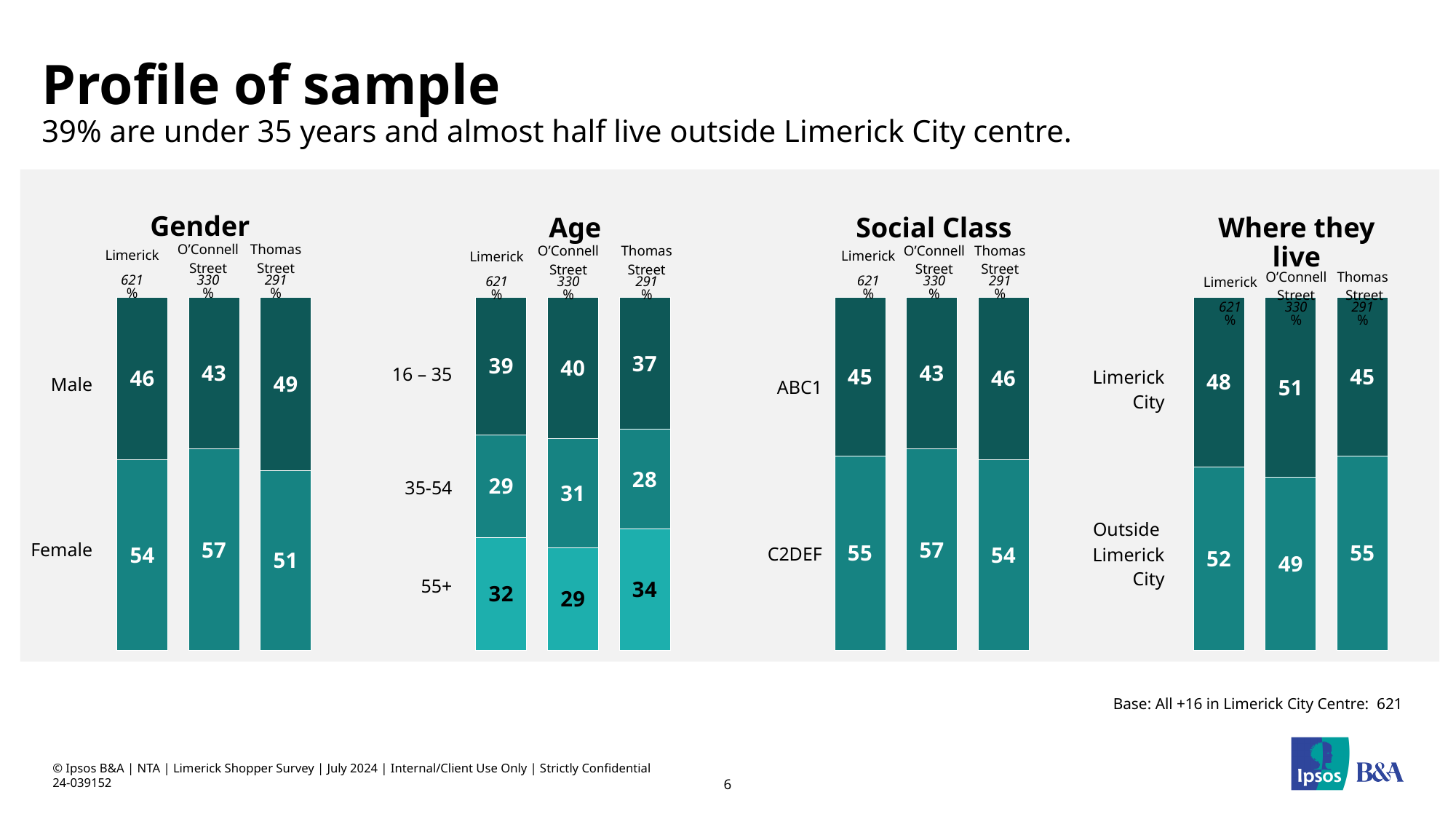
In the Gender chart, what percentage of the Limerick sample is Female? 54 What type of chart is the Gender chart? Stacked bar chart In the Age chart, which location has the highest 55+ value? Thomas Street How many bars are shown in the Age chart? 3 How many age groups are shown in the Age chart? 3 In the Where they live chart, which location has the highest Limerick City value? O'Connell Street In the Where they live chart, what is the Outside Limerick City value for O'Connell Street? 49 In the Social Class chart, what is the difference between the C2DEF values for O'Connell Street and Thomas Street? 3 In the Age chart, which location has the lowest 35-54 value? Thomas Street In the Age chart, what is the 16 – 35 value for O'Connell Street? 40 In the Social Class chart, which is larger: the ABC1 value for Limerick or for Thomas Street? Thomas Street In the Gender chart, what is the Male value for Thomas Street? 49